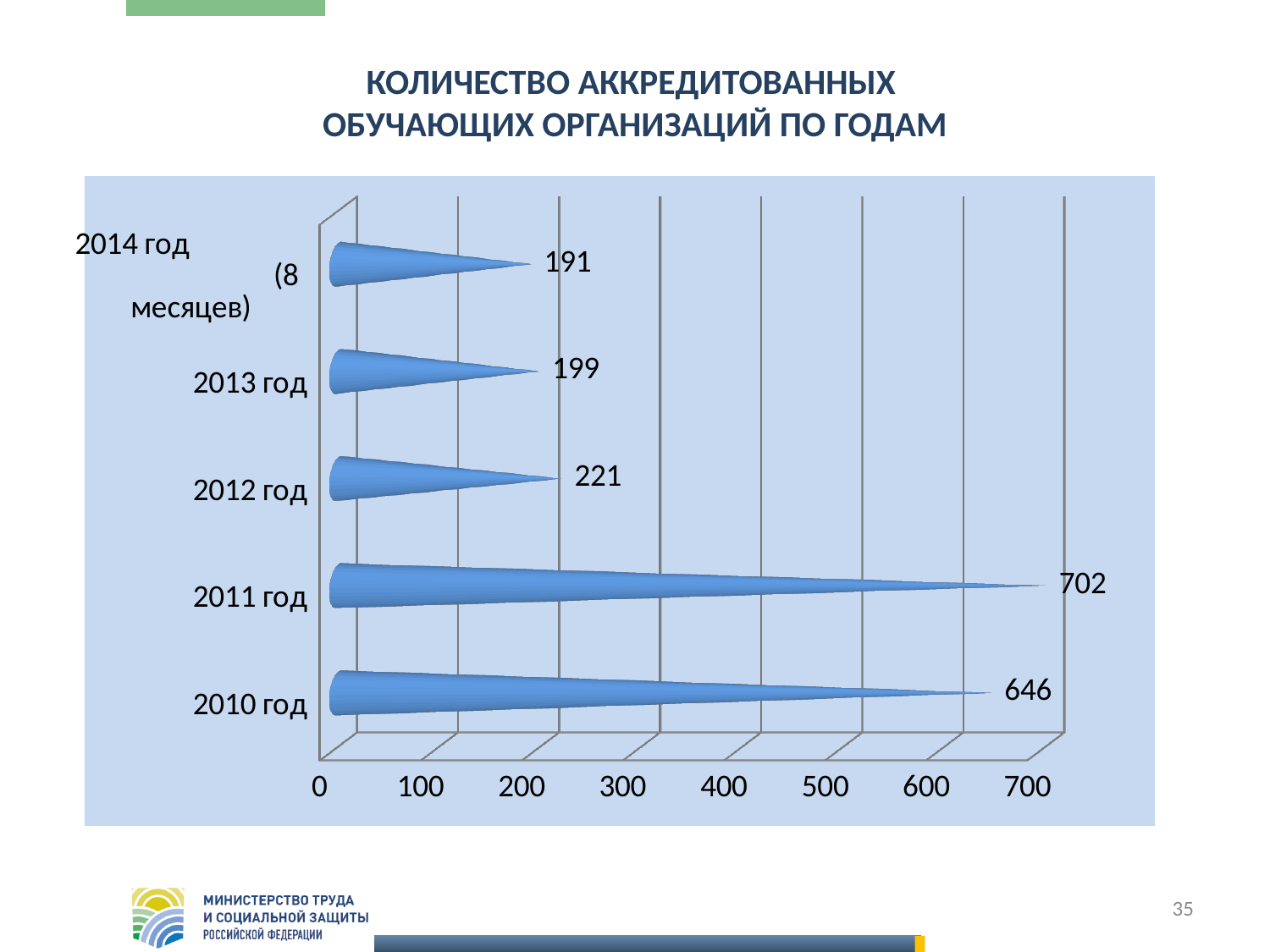
What is the value for 2010 год? 646 Which category has the lowest value? 2014 год (8 месяцев) Which is larger, the value for 2012 год or the value for 2013 год? 2012 год Which year has the highest value? 2011 год What kind of chart is shown on the slide? Bar chart What is the title of the chart? КОЛИЧЕСТВО АККРЕДИТОВАННЫХ ОБУЧАЮЩИХ ОРГАНИЗАЦИЙ ПО ГОДАМ How many categories are shown on the chart? 5 What is the value for 2013 год? 199 What is the difference between the values for 2011 год and 2010 год? 56 What is the value for 2012 год? 221 What is the value for 2014 год (8 месяцев)? 191 What is the value for 2011 год? 702